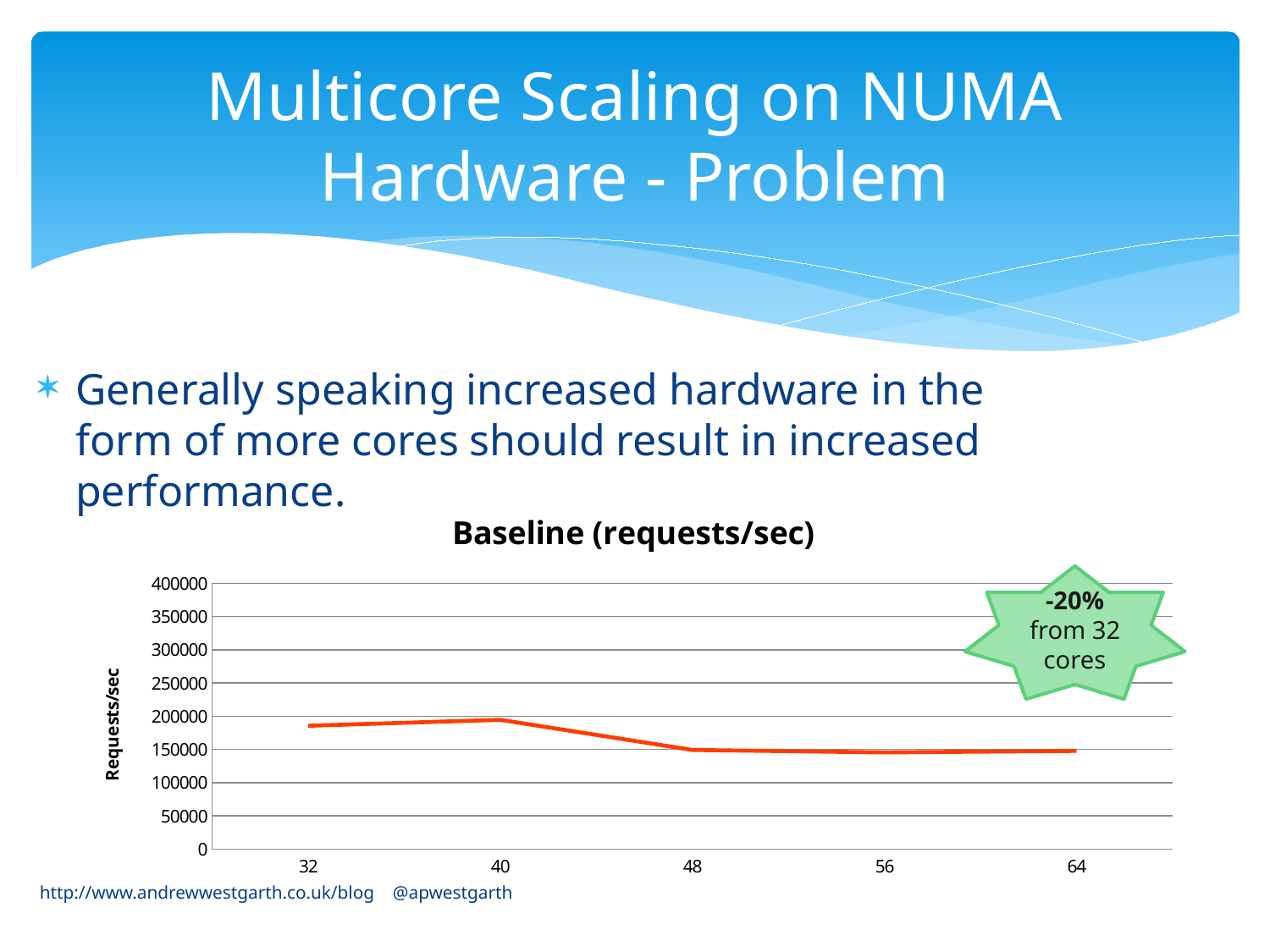
Is the value at 32 cores greater or less than 150000? greater Which has the larger value, 32 cores or 48 cores? 32 cores What is the title of the chart? Baseline (requests/sec) Is the value at 48 cores greater or less than 200000? less What kind of chart is shown on the slide? line chart At which core count is the value highest? 40 What is the label on the vertical axis? Requests/sec Is the value at 64 cores greater or less than 100000? greater How many data points are plotted on the line? 5 What is the highest tick value shown on the vertical axis? 400000 Does the value rise or fall overall from 32 cores to 64 cores? fall